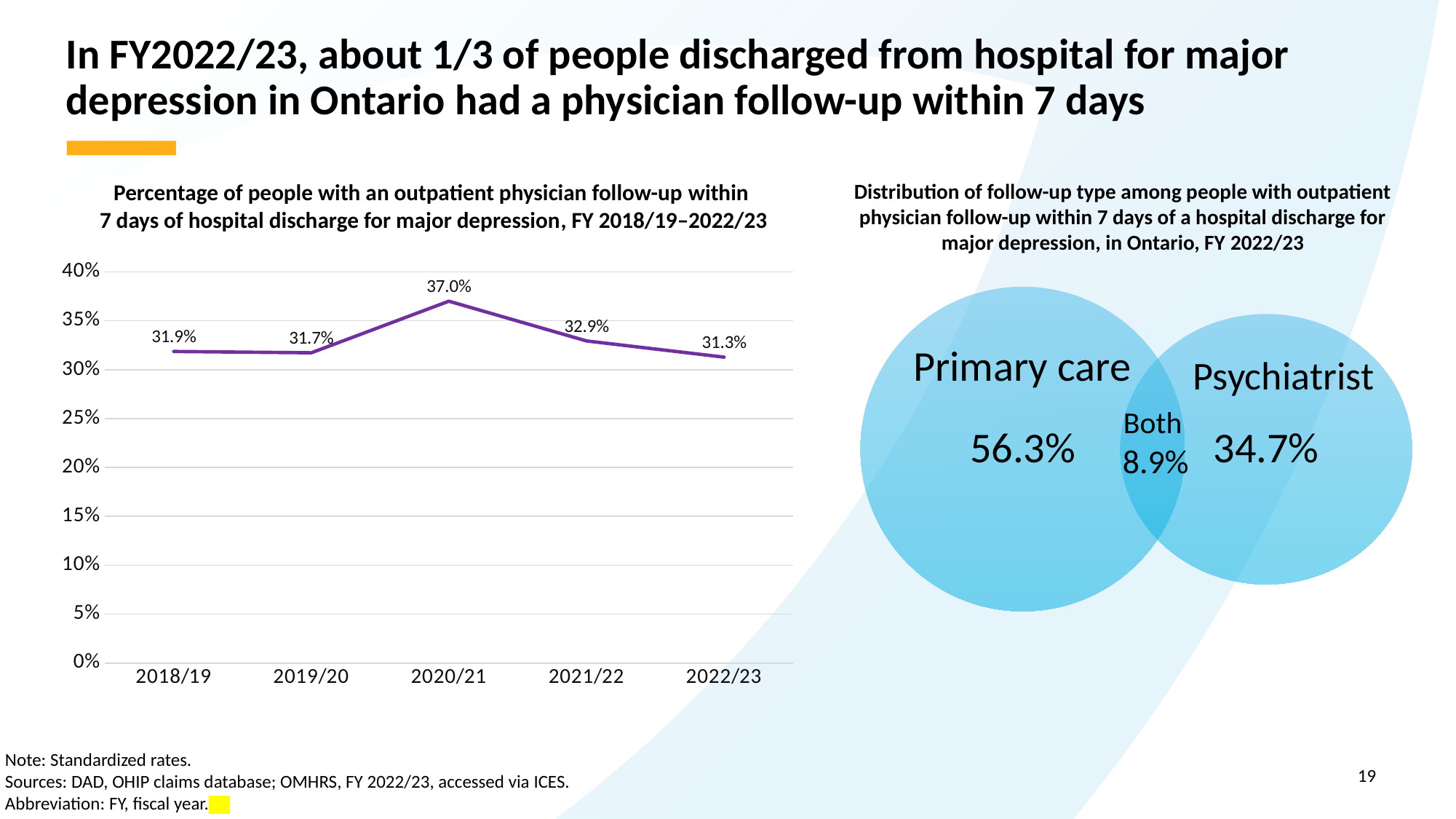
In the line chart on the left, what is the difference between the FY 2020/21 value and the FY 2022/23 value? 5.7 percentage points What type of chart is shown on the left of the slide? Line chart In the line chart on the left, did the percentage rise or fall from FY 2020/21 to FY 2022/23? Fall In the line chart on the left, what was the percentage of people with an outpatient physician follow-up within 7 days in FY 2020/21? 37.0% In the line chart on the left, how many fiscal years are plotted? 5 In the line chart on the left, what was the percentage in FY 2018/19? 31.9% In the line chart on the left, which year had a higher percentage, 2019/20 or 2021/22? 2021/22 In the line chart on the left, what was the percentage in FY 2022/23? 31.3% In the Venn diagram on the right, what percentage of people had follow-up with both primary care and a psychiatrist? 8.9% In the line chart on the left, which fiscal year had the highest percentage? 2020/21 In the line chart on the left, which fiscal year had the lowest percentage? 2022/23 In the Venn diagram on the right, what percentage of people had follow-up with a psychiatrist? 34.7%